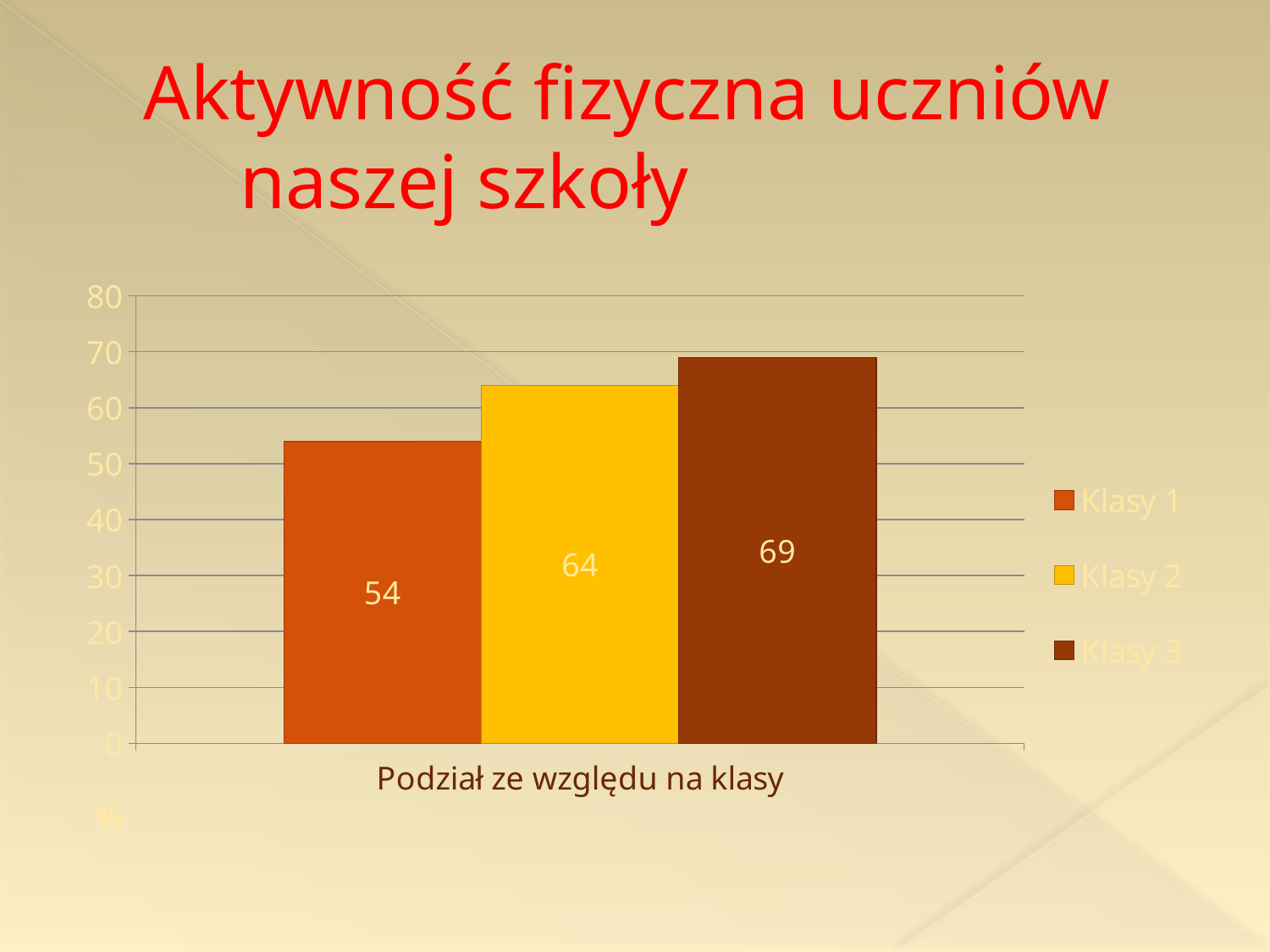
Is the value for Klasy 3 greater or less than 60? greater What is the value for Klasy 1? 54 What kind of chart is shown on the slide? bar chart What is the value for Klasy 2? 64 What is the difference between the values for Klasy 2 and Klasy 1? 10 What is the value for Klasy 3? 69 Which is larger, the value for Klasy 2 or the value for Klasy 3? Klasy 3 Which series has the lowest value? Klasy 1 Which series has the highest value? Klasy 3 What is the label on the x axis of the chart? Podział ze względu na klasy How many series does the legend list? 3 What is the difference between the values for Klasy 3 and Klasy 1? 15